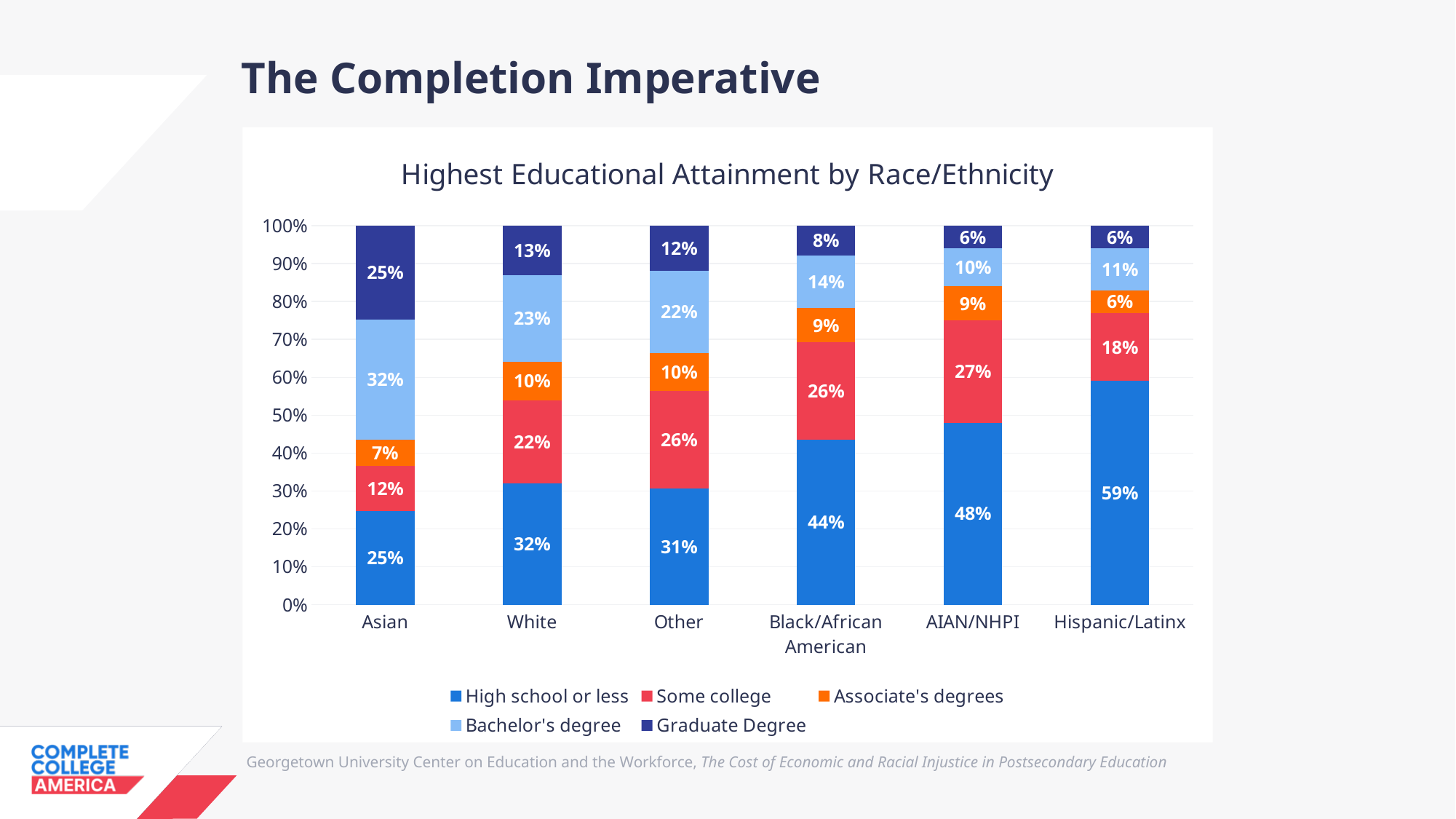
How many race/ethnicity categories are shown on the x axis? 6 Which has a larger Associate's degrees share, Asian or White? White What is the difference between the Some college share for White and for Asian? 10 percentage points What is the Some college value for Black/African American? 26% Which category has the highest Bachelor's degree share? Asian What is the Graduate Degree share for the Asian category? 25% Which race/ethnicity category has the lowest share of High school or less? Asian Which race/ethnicity category has the highest share of High school or less? Hispanic/Latinx What percentage of Hispanic/Latinx individuals have a highest educational attainment of high school or less? 59% What is the Bachelor's degree value for the White category? 23% What type of chart is shown on the slide? Stacked bar chart How many series does the legend list? 5